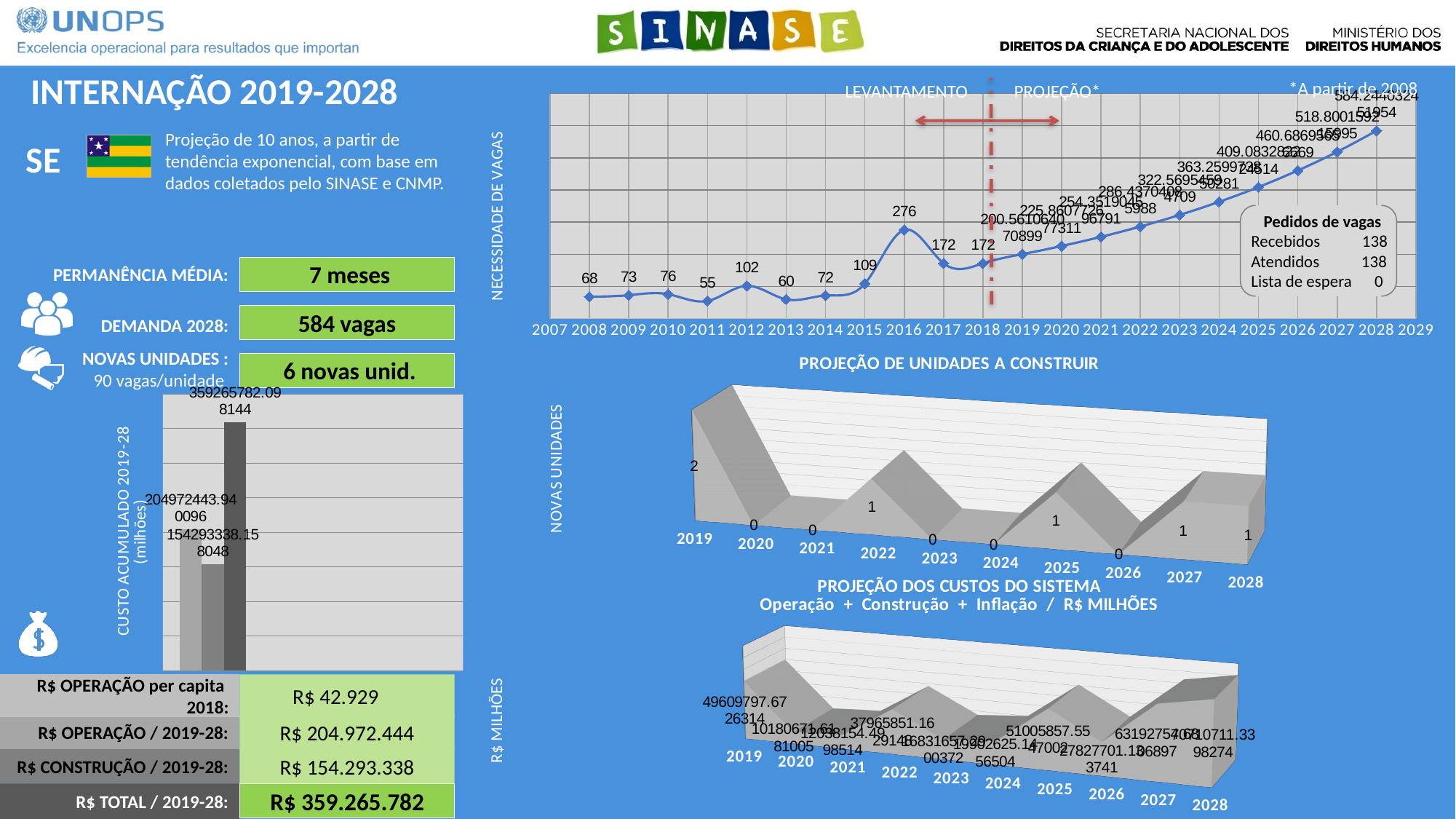
In the NECESSIDADE DE VAGAS line chart, do the values rise or fall from 2018 to 2028? rise In the NECESSIDADE DE VAGAS line chart, what is the value for 2012? 102 In the NECESSIDADE DE VAGAS line chart, which year has the larger value, 2012 or 2014? 2012 In the NECESSIDADE DE VAGAS line chart, what is the value for 2011? 55 In the NECESSIDADE DE VAGAS line chart, which year has the highest value? 2028 In the PROJEÇÃO DE UNIDADES A CONSTRUIR chart, how many years are shown on the x axis? 10 What kind of chart is the NECESSIDADE DE VAGAS chart at the top right? line chart In the PROJEÇÃO DE UNIDADES A CONSTRUIR chart, what is the value for 2019? 2 In the NECESSIDADE DE VAGAS line chart, what is the difference between the values for 2016 and 2015? 167 How many bars are in the CUSTO ACUMULADO 2019-28 bar chart on the left of the slide? 3 In the NECESSIDADE DE VAGAS line chart, what is the value for 2016? 276 In the NECESSIDADE DE VAGAS line chart, which year has the lowest value? 2011